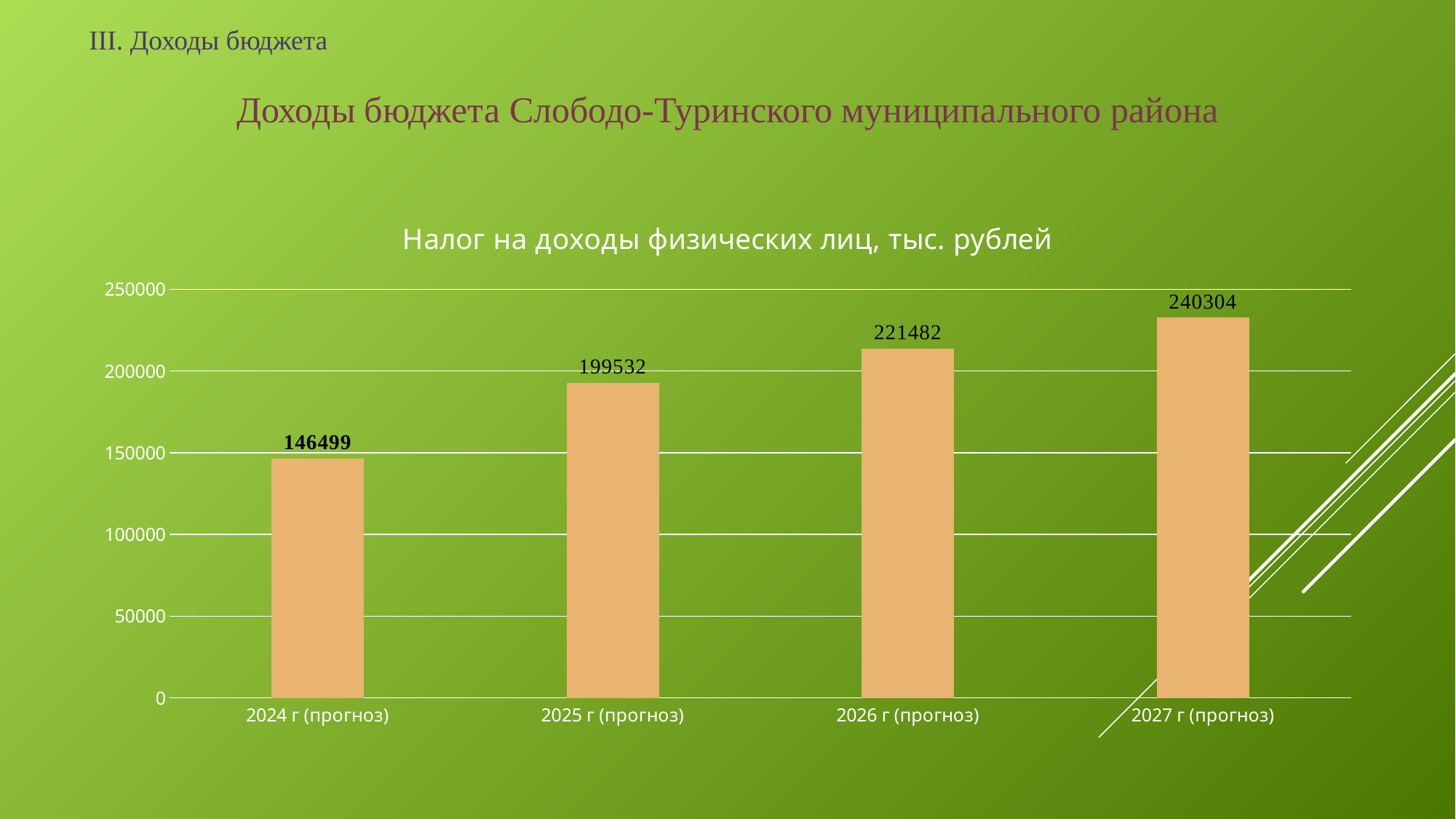
What kind of chart is shown? bar chart Which is larger, the value for 2025 г (прогноз) or 2026 г (прогноз)? 2026 г (прогноз) What is the value for 2027 г (прогноз)? 240304 Which year has the lowest value? 2024 г (прогноз) What is the difference between the values for 2026 г (прогноз) and 2025 г (прогноз)? 21950 What is the difference between the values for 2027 г (прогноз) and 2024 г (прогноз)? 93805 What is the value for 2024 г (прогноз)? 146499 How many bars are shown in the chart? 4 Which year has the highest value? 2027 г (прогноз) What is the value for 2026 г (прогноз)? 221482 What is the value for 2025 г (прогноз)? 199532 Is the value for 2025 г (прогноз) greater or less than 200000? less